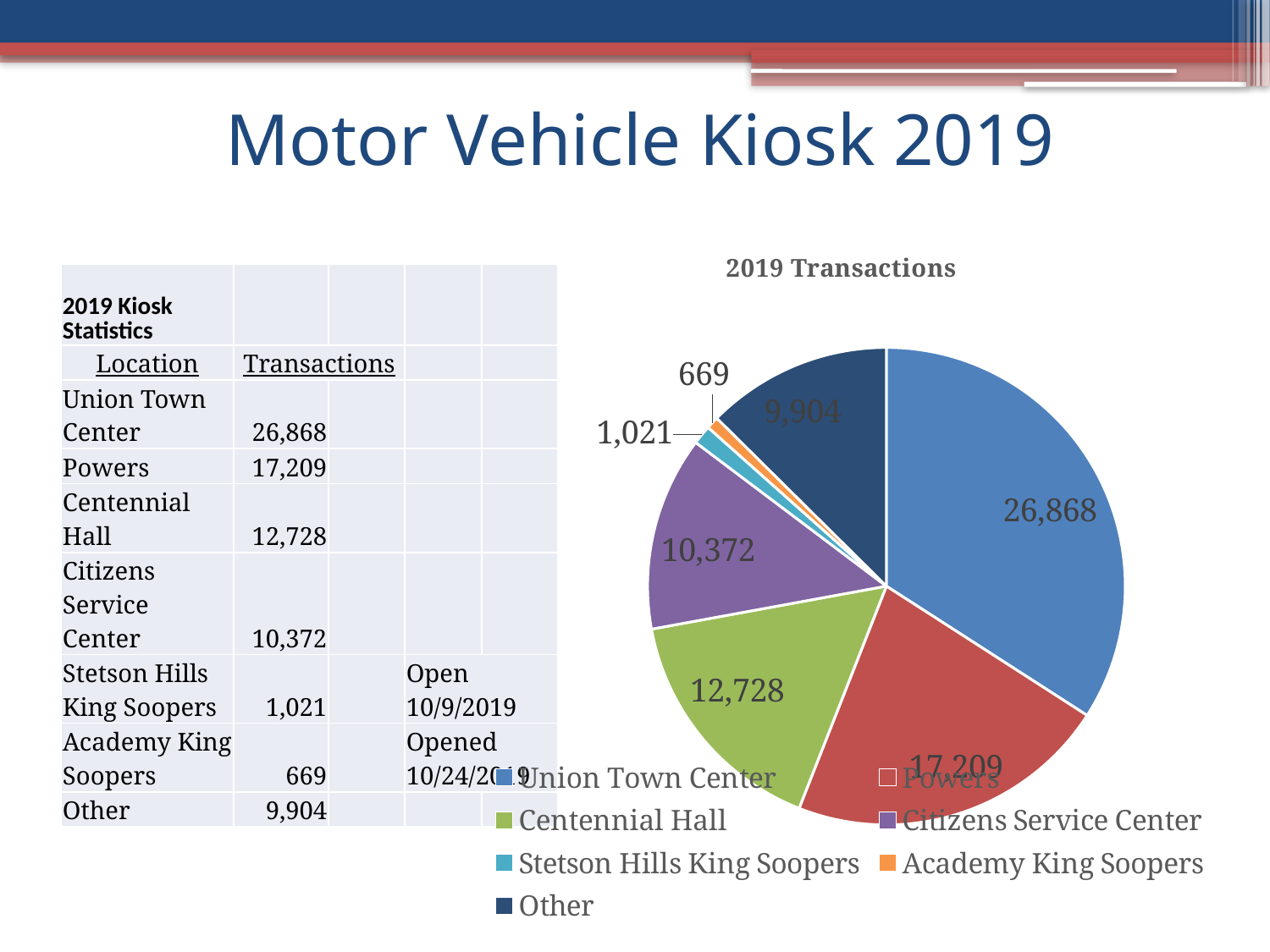
How many slices does the pie chart have? 7 Which is larger, the value for Centennial Hall or the value for Other? Centennial Hall How many entries does the chart legend list? 7 What is the value for Union Town Center in the pie chart? 26,868 What is the value for Citizens Service Center in the pie chart? 10,372 Which category has the smallest slice in the pie chart? Academy King Soopers What is the title of the chart? 2019 Transactions Which category has the largest slice in the pie chart? Union Town Center What is the value for Academy King Soopers in the pie chart? 669 What is the difference between the values for Union Town Center and Powers? 9,659 What type of chart is shown on the slide? pie chart What is the difference between the values for Stetson Hills King Soopers and Academy King Soopers? 352